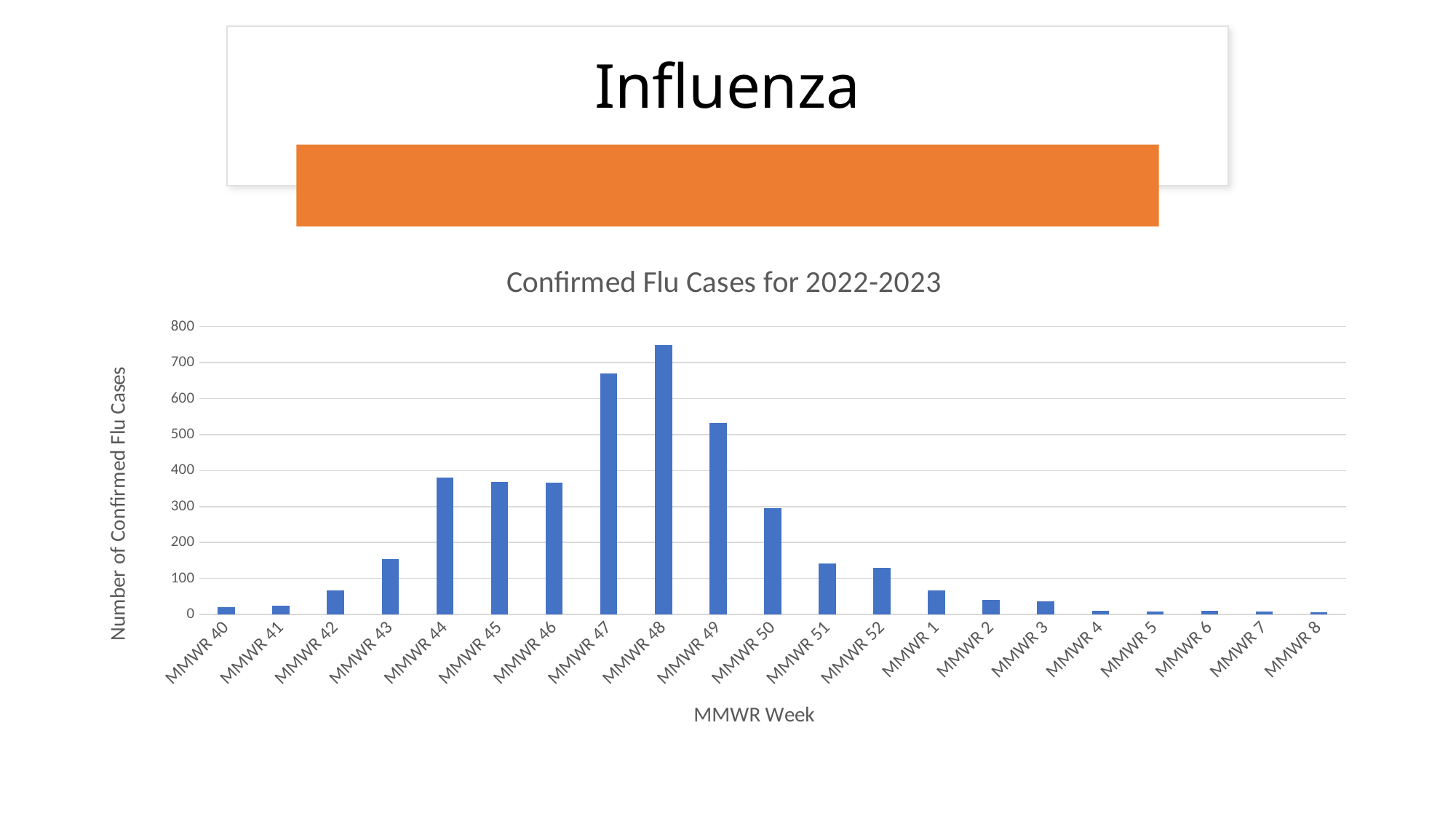
Is the value for MMWR 47 greater or less than 600? greater Is the value for MMWR 49 greater or less than 500? greater How many MMWR weeks are plotted on the x axis? 21 What kind of chart is shown on the slide? Bar chart Is the value for MMWR 44 greater or less than 400? less Which has more confirmed flu cases, MMWR 47 or MMWR 49? MMWR 47 Which MMWR week has the highest number of confirmed flu cases? MMWR 48 Do the values rise or fall from MMWR 48 to MMWR 8? fall What is the label of the vertical axis? Number of Confirmed Flu Cases What is the title of the chart? Confirmed Flu Cases for 2022-2023